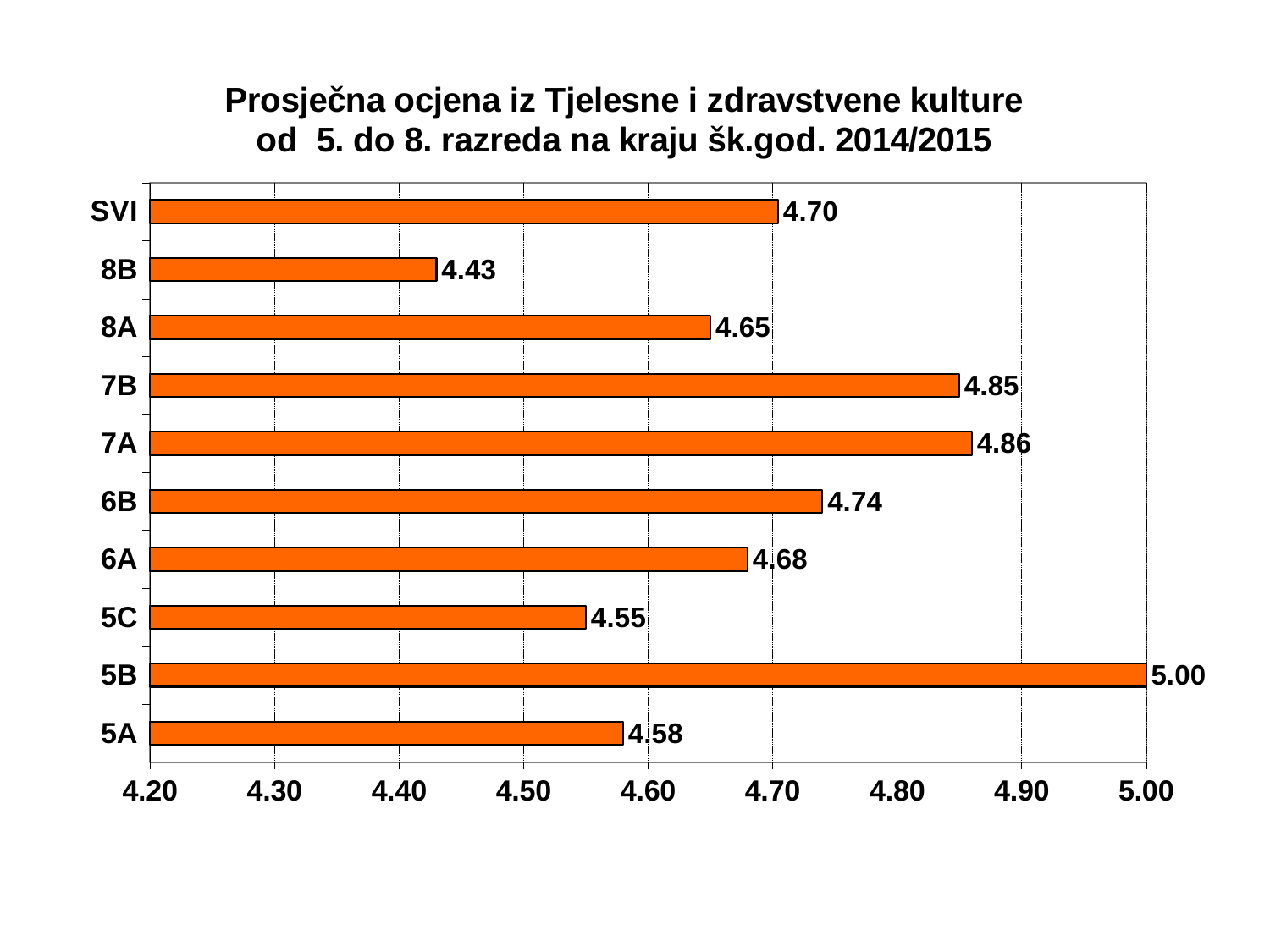
Which has a higher value, 7B or 8A? 7B How many categories are shown on the chart? 10 What is the value shown for 8B? 4.43 What is the value shown for SVI? 4.70 What is the difference between the values for 6B and 6A? 0.06 Is the value for 5C greater or less than 4.60? less What is the difference between the values for 5B and 8B? 0.57 Which class has the lowest average grade? 8B Which class has the highest average grade? 5B What is the average grade for class 5B? 5.00 What colour are the bars in the chart? Orange What kind of chart is shown on the slide? Bar chart